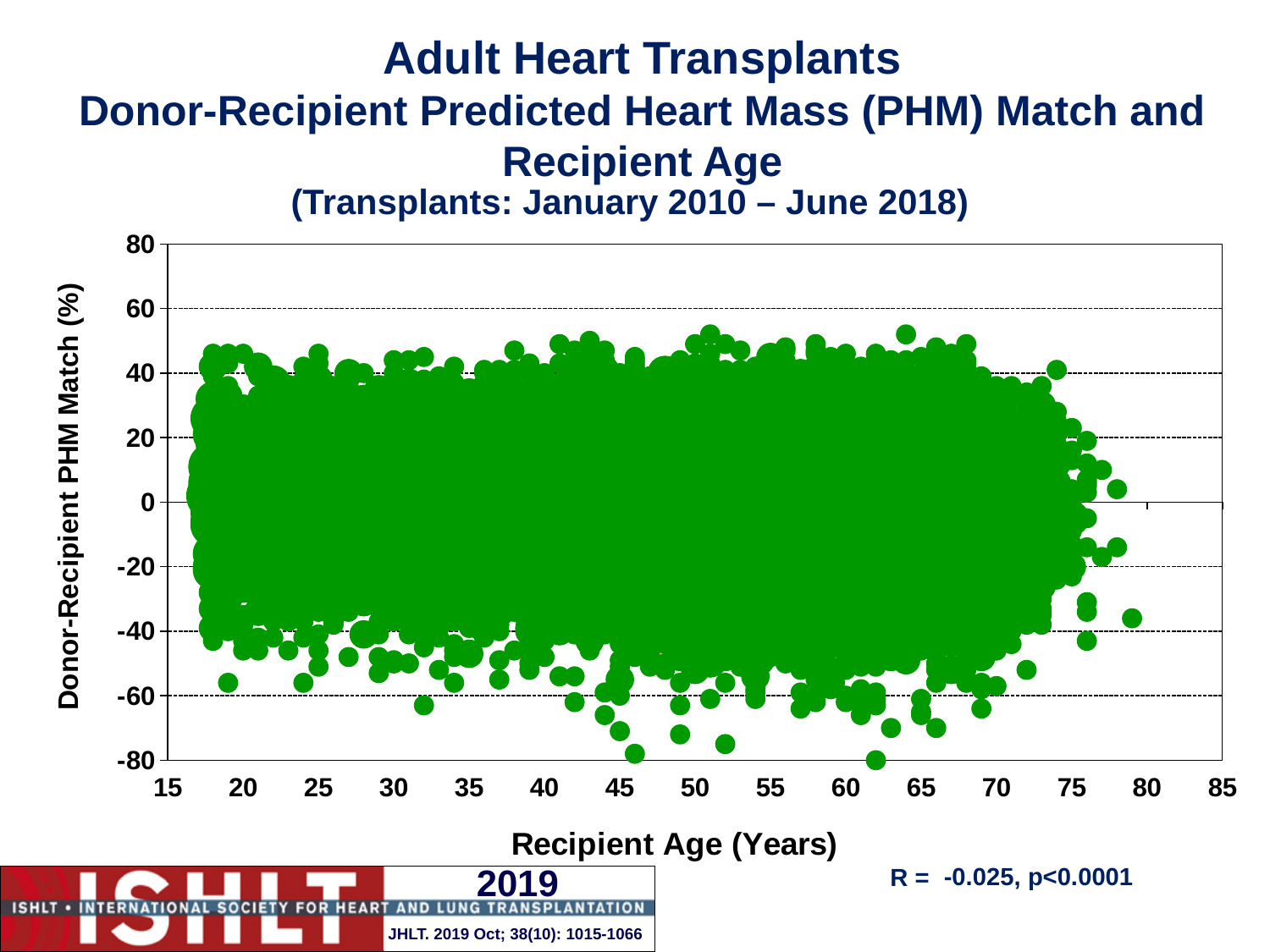
Is the highest plotted Donor-Recipient PHM Match value greater or less than 60? less What kind of chart is shown on the slide? scatter plot What is the correlation coefficient R reported on the slide? -0.025 What p-value is reported on the slide? p<0.0001 Is the highest recipient age plotted greater or less than 80? less What transplant period does the chart cover, according to the title? January 2010 – June 2018 Is the lowest plotted Donor-Recipient PHM Match value greater or less than -60? less What is the label of the x axis? Recipient Age (Years)